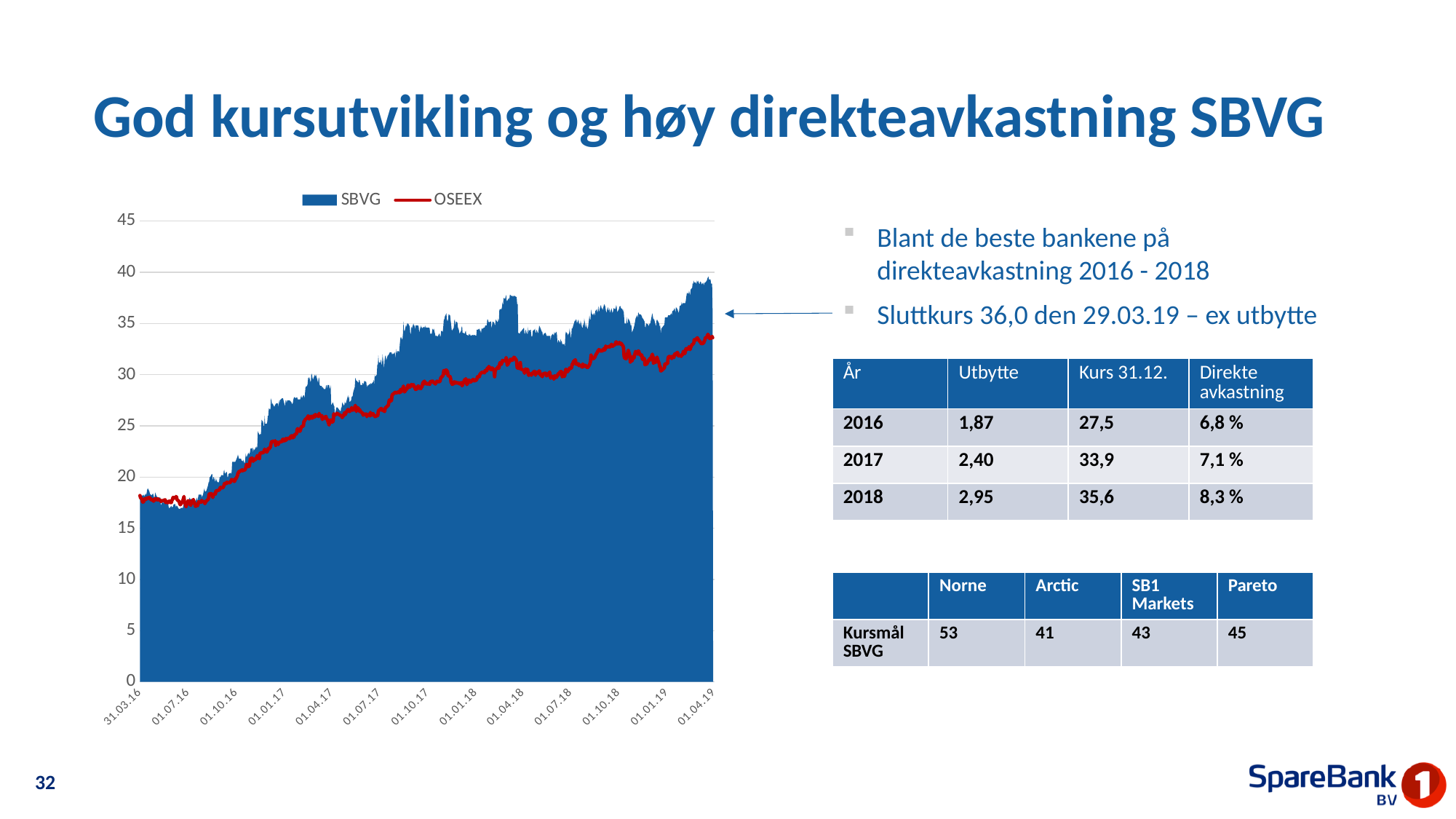
Does the SBVG series generally rise or fall from 31.03.16 to 01.04.19? rise Which series in the chart is drawn as a red line? OSEEX What are the two series named in the chart legend? SBVG and OSEEX At 01.04.19, which series has the higher value, SBVG or OSEEX? SBVG What is the highest value shown on the chart's vertical axis? 45 How many date labels are shown along the chart's x axis? 13 Is the OSEEX value at 01.04.19 greater or less than 30? greater Is the OSEEX value at 01.01.17 greater or less than 30? less Is the SBVG value at 31.03.16 greater or less than 20? less At 01.04.18, which series has the higher value, SBVG or OSEEX? SBVG How many series does the chart legend list? 2